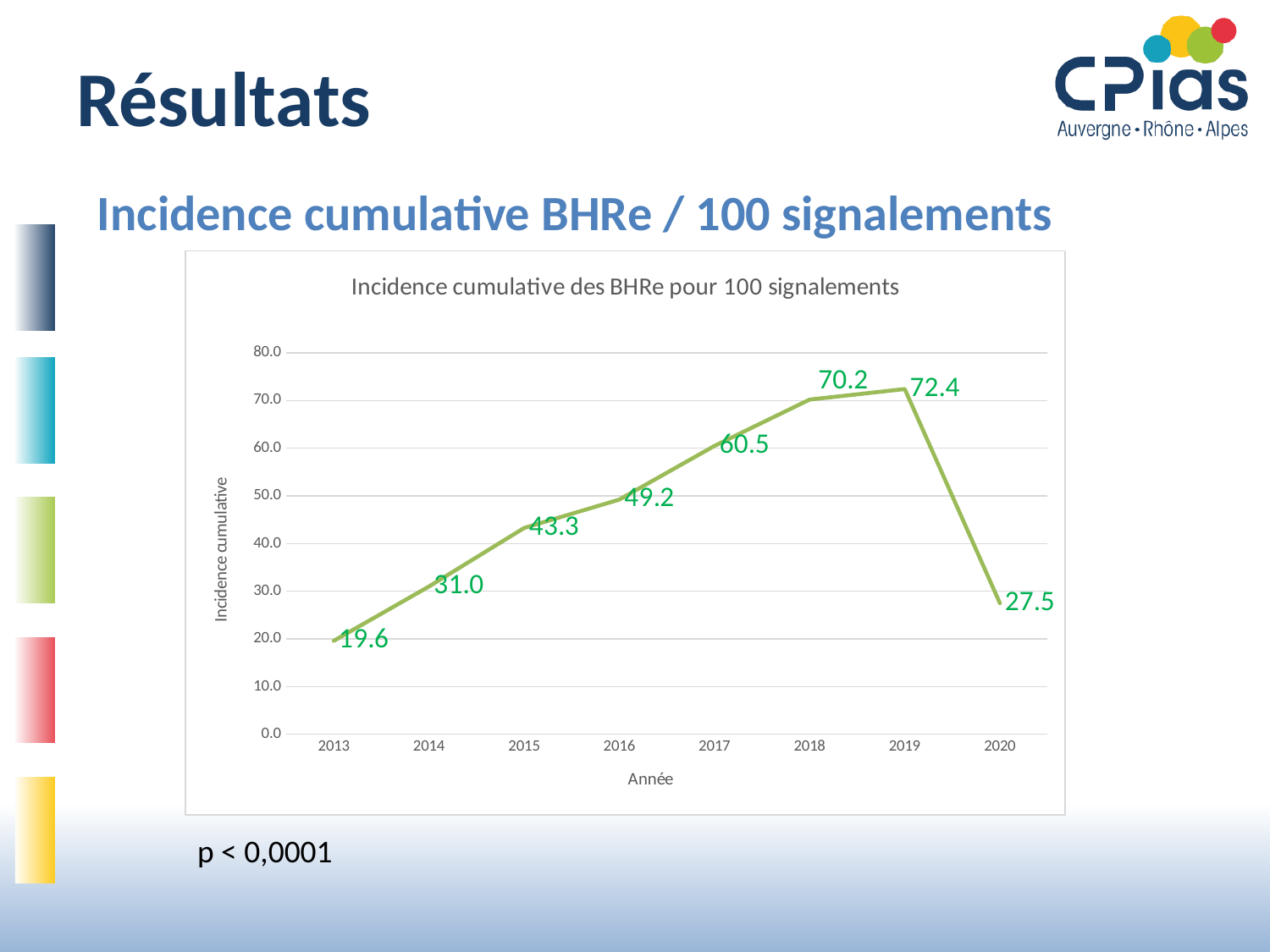
Which year has the lowest cumulative incidence? 2013 What is the difference between the values for 2014 and 2013? 11.4 What is the cumulative incidence value for 2013? 19.6 Which year has the highest cumulative incidence? 2019 What is the cumulative incidence value for 2017? 60.5 Which year has a larger value, 2016 or 2020? 2016 Do the values rise or fall from 2013 to 2019? rise How many years are plotted on the x axis? 8 What is the title of the chart? Incidence cumulative des BHRe pour 100 signalements What is the difference between the values for 2019 and 2020? 44.9 What kind of chart is shown? line chart What is the cumulative incidence value for 2020? 27.5